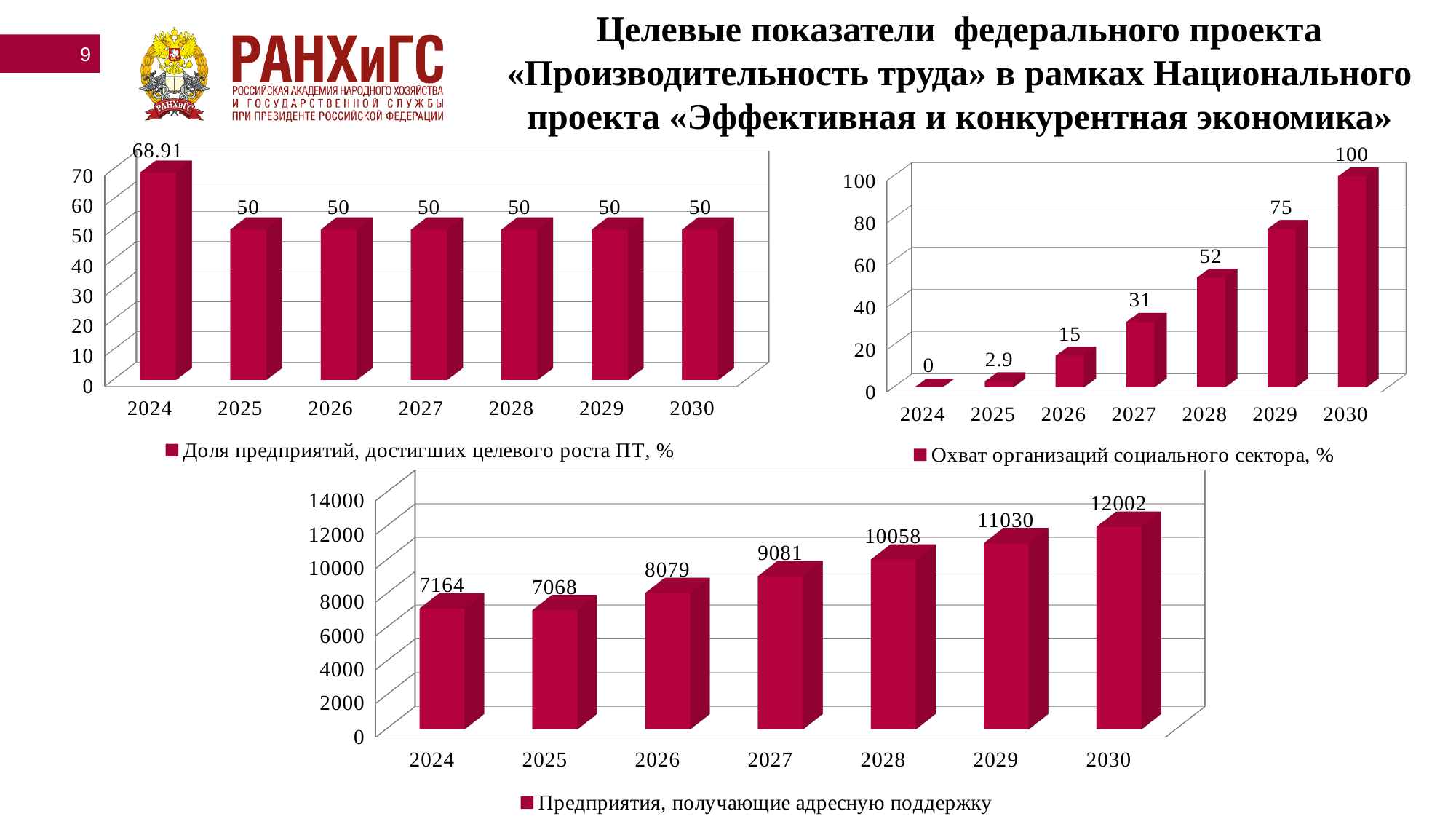
In the top-left chart (Доля предприятий, достигших целевого роста ПТ, %), what is the difference between the 2024 value and the 2025 value? 18.91 How many years are shown on the x axis of the bottom chart (Предприятия, получающие адресную поддержку)? 7 In the top-right chart (Охват организаций социального сектора, %), what is the value for 2027? 31 What type of chart is the top-right chart (Охват организаций социального сектора, %)? bar chart In the bottom chart (Предприятия, получающие адресную поддержку), what is the value for 2028? 10058 In the top-left chart (Доля предприятий, достигших целевого роста ПТ, %), which year has the highest value? 2024 In the bottom chart (Предприятия, получающие адресную поддержку), which year has the lowest value? 2025 In the top-right chart (Охват организаций социального сектора, %), do the values rise or fall from 2024 to 2030? rise In the bottom chart (Предприятия, получающие адресную поддержку), which is larger: the value for 2026 or the value for 2027? 2027 In the top-right chart (Охват организаций социального сектора, %), which year has the lowest value? 2024 In the top-left chart (Доля предприятий, достигших целевого роста ПТ, %), what is the value for 2024? 68.91 In the top-right chart (Охват организаций социального сектора, %), what is the difference between the 2030 value and the 2029 value? 25